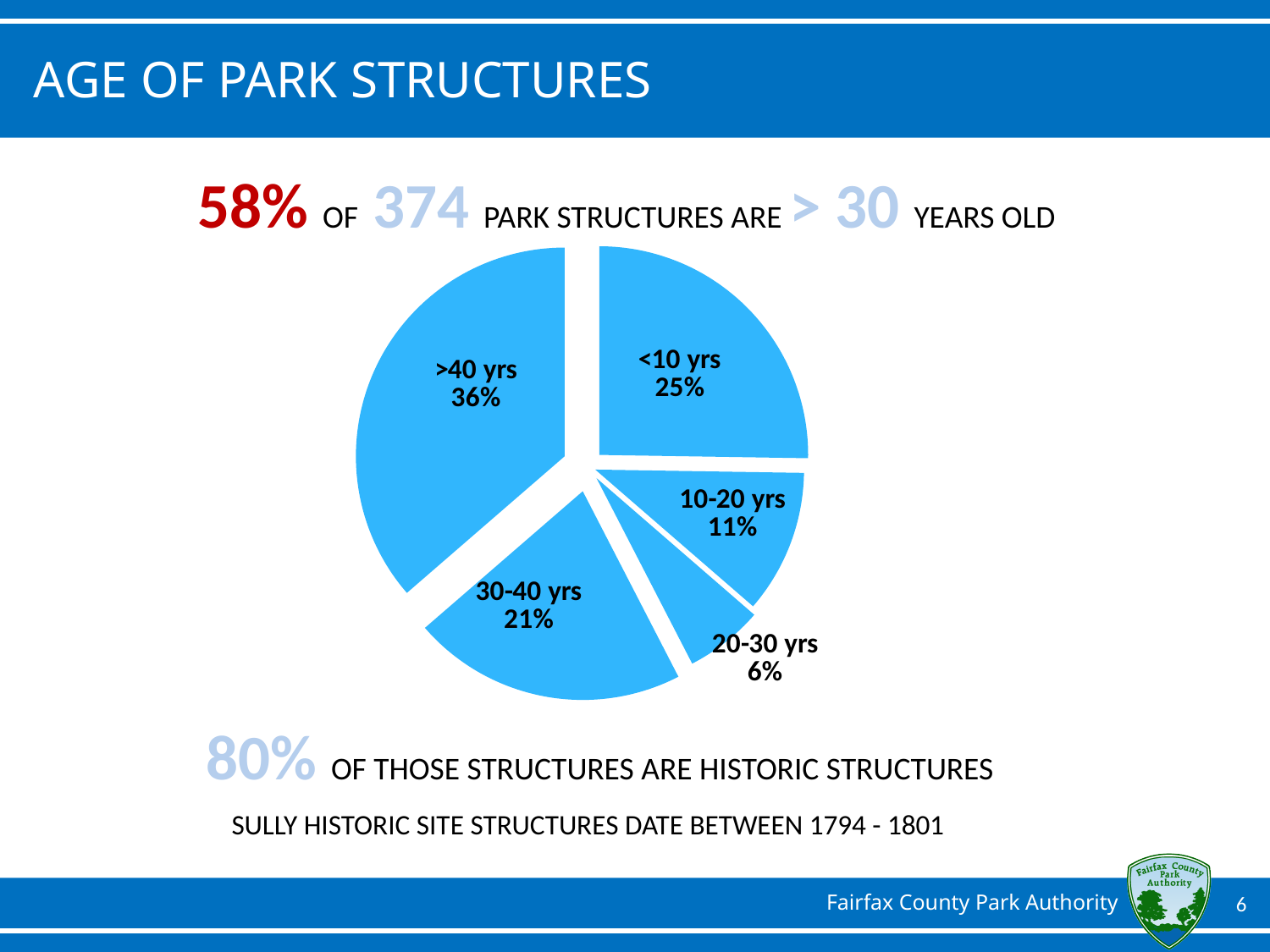
What share of park structures are >40 yrs old? 36% Which age category has the largest share of park structures? >40 yrs Which age category has the smallest share of park structures? 20-30 yrs What percentage is shown for the 20-30 yrs slice? 6% What is the difference in percentage points between the >40 yrs slice and the 30-40 yrs slice? 15 What is the title of the slide containing the chart? AGE OF PARK STRUCTURES What kind of chart is shown on the slide? Pie chart Which slice is larger, <10 yrs or 10-20 yrs? <10 yrs How many age categories does the pie chart show? 5 What percentage is shown for the 30-40 yrs slice? 21% What share of park structures are <10 yrs old? 25% What percentage is shown for the 10-20 yrs slice? 11%